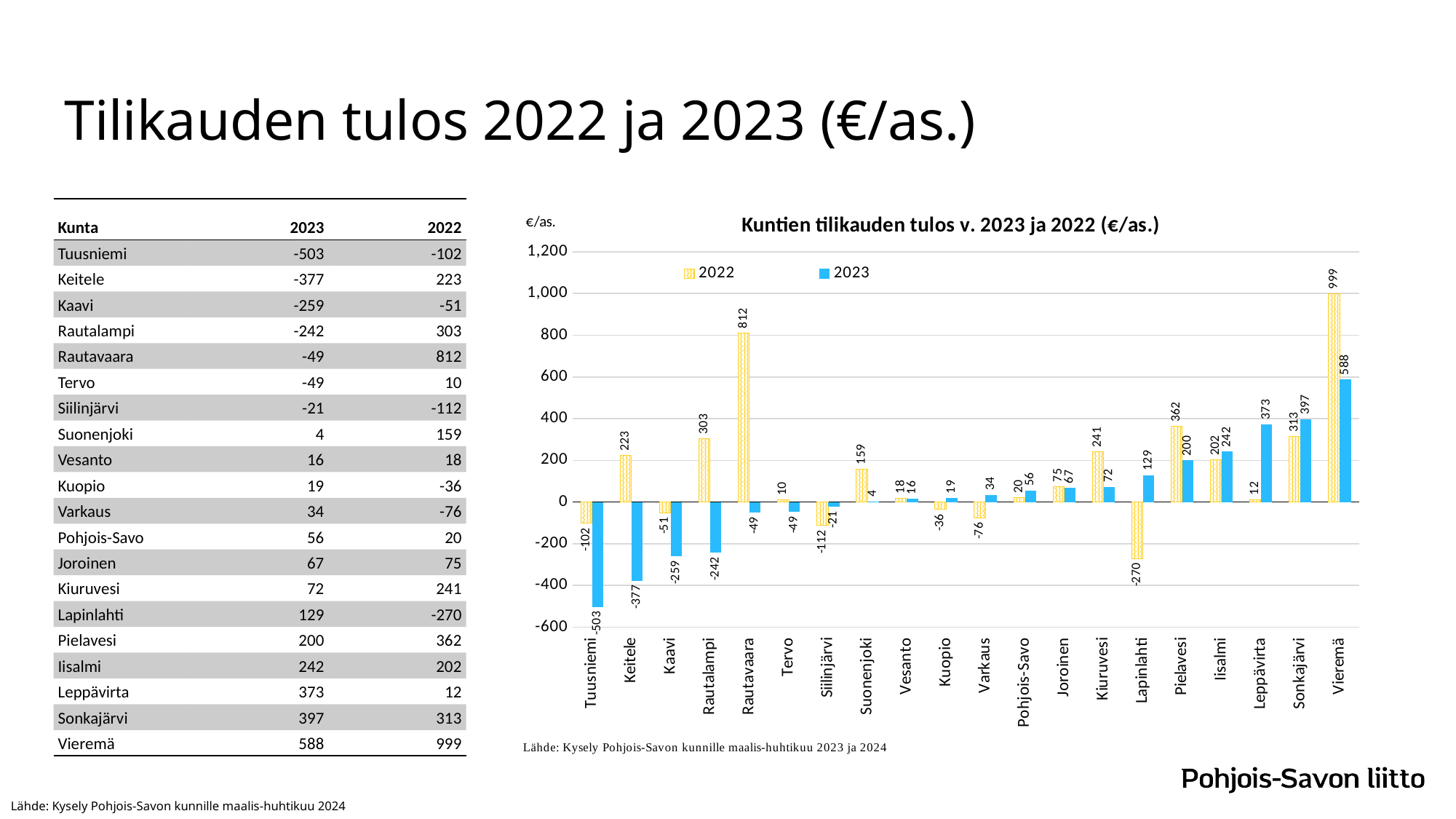
What is the 2023 value for Lapinlahti in the chart? 129 What is the 2023 value for Tuusniemi in the chart? -503 For Leppävirta, which is larger: the 2022 value or the 2023 value? 2023 What is the title of the chart? Kuntien tilikauden tulos v. 2023 ja 2022 (€/as.) What is the difference between the 2022 and 2023 values for Vieremä? 411 How many municipalities are shown on the x axis of the chart? 20 How many series does the chart legend list? 2 What is the 2022 value for Rautavaara in the chart? 812 Which colour represents the 2023 series in the chart? blue What kind of chart is shown on the slide? bar chart Which municipality has the highest 2022 value in the chart? Vieremä Which municipality has the lowest 2023 value in the chart? Tuusniemi